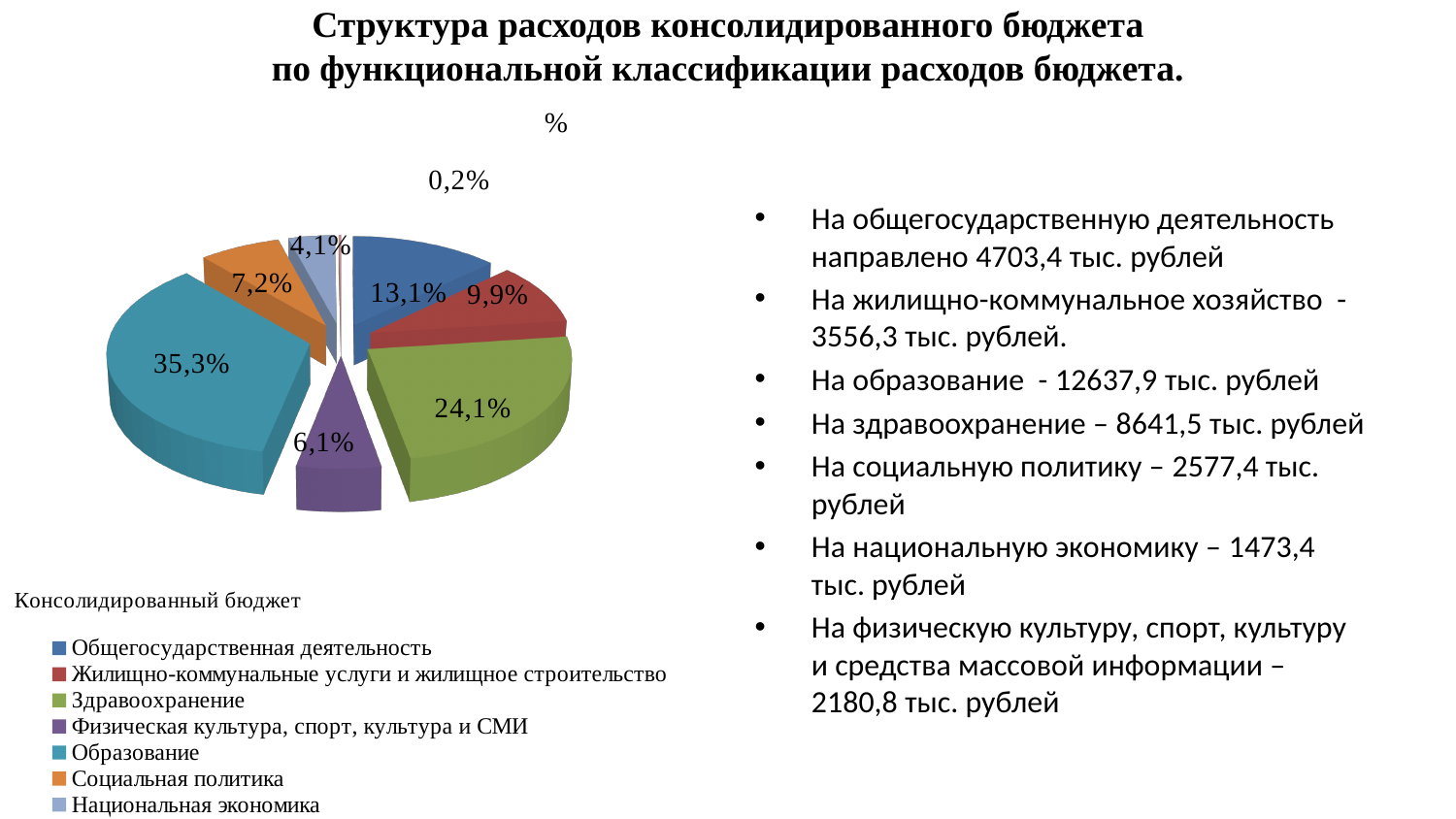
What is the value for Общегосударственная деятельность? 13,1% What percentage does the slice for Физическая культура, спорт, культура и СМИ show? 6,1% What kind of chart is shown on the slide? Pie chart Which category has the largest slice of the pie? Образование What share is labelled for Социальная политика? 7,2% How many entries does the chart legend list? 7 What share of the pie does Образование account for? 35,3% Which is larger: Общегосударственная деятельность or Здравоохранение? Здравоохранение Which is larger: Жилищно-коммунальные услуги и жилищное строительство or Социальная политика? Жилищно-коммунальные услуги и жилищное строительство What is the value for Национальная экономика? 4,1% By how many percentage points does Образование exceed Здравоохранение? 11,2% What percentage is shown for Здравоохранение? 24,1%